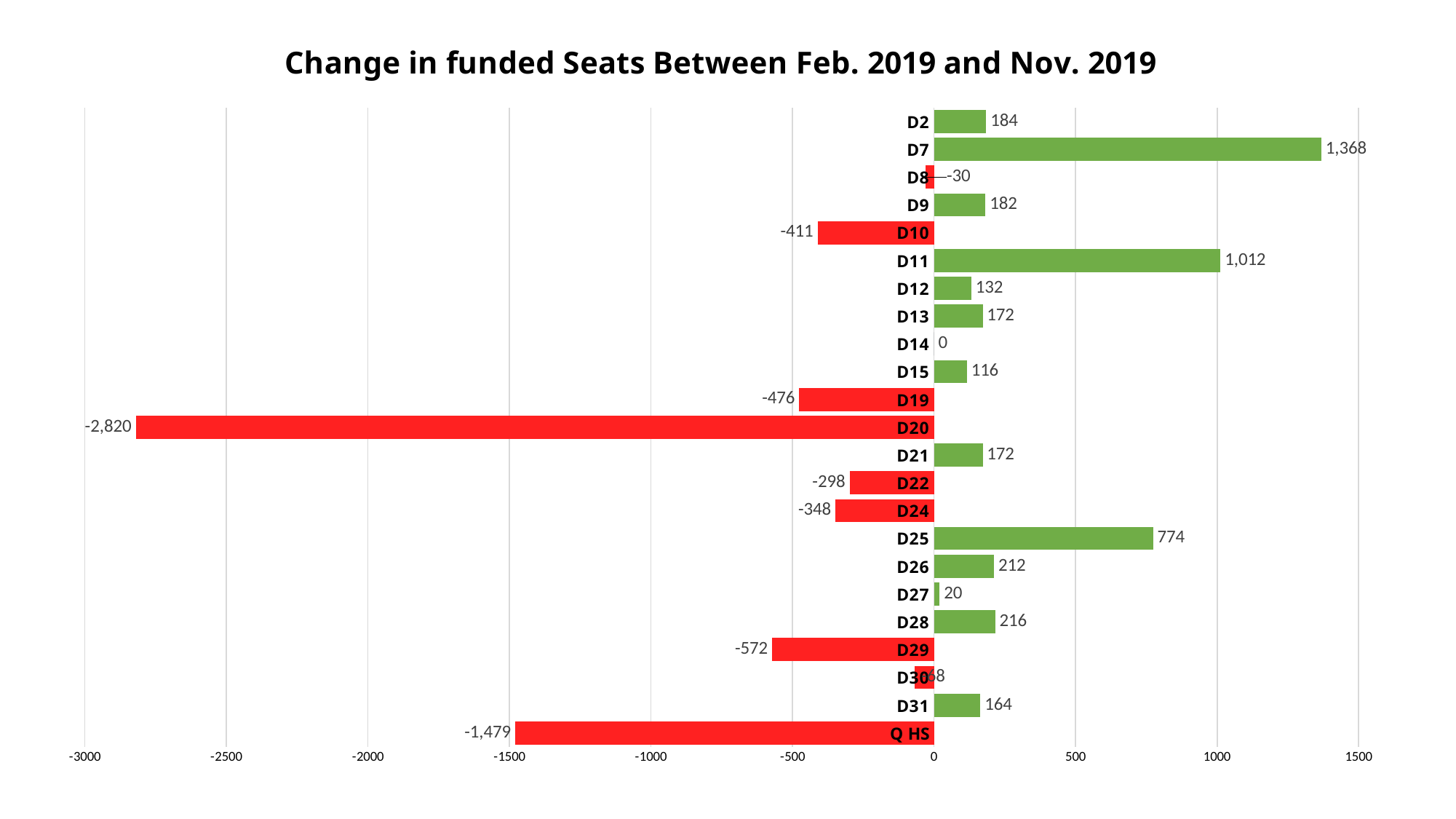
Which is larger, the value for D25 or the value for D11? D11 What is the difference between the values for D7 and D11? 356 What is the value for D14? 0 What is the value for D7? 1,368 How many categories are shown in the chart? 23 Is the value for D29 greater or less than -500? less What is the value for D20? -2,820 Which category has the highest value? D7 What kind of chart is shown on the slide? bar chart What is the title of the chart? Change in funded Seats Between Feb. 2019 and Nov. 2019 What is the value for Q HS? -1,479 Which category has the lowest value? D20